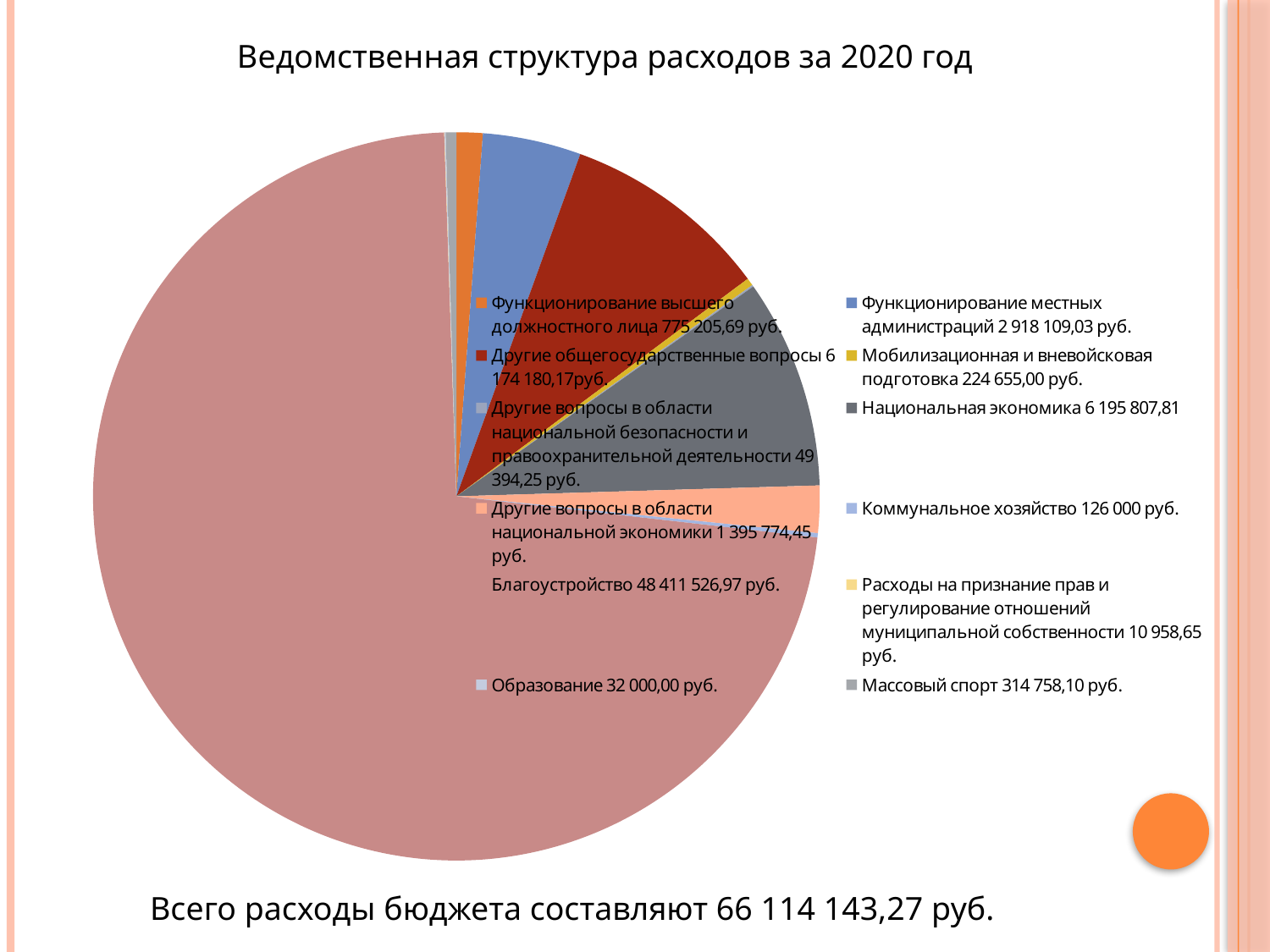
Which is larger: Функционирование местных администраций or Функционирование высшего должностного лица? Функционирование местных администраций What kind of chart is shown on the slide? Pie chart How many categories does the legend of the pie chart list? 12 What is the value for Национальная экономика? 6 195 807,81 Which category has the smallest value in the legend? Расходы на признание прав и регулирование отношений муниципальной собственности What is the value for Массовый спорт? 314 758,10 руб. What is the value for Функционирование местных администраций? 2 918 109,03 руб. Which category has the largest slice of the pie? Благоустройство According to the text below the chart, what is the total budget expenditure? 66 114 143,27 руб. What is the title of the chart on the slide? Ведомственная структура расходов за 2020 год What is the difference between Функционирование местных администраций (2 918 109,03 руб.) and Функционирование высшего должностного лица (775 205,69 руб.)? 2 142 903,34 руб. What is the value for Благоустройство? 48 411 526,97 руб.